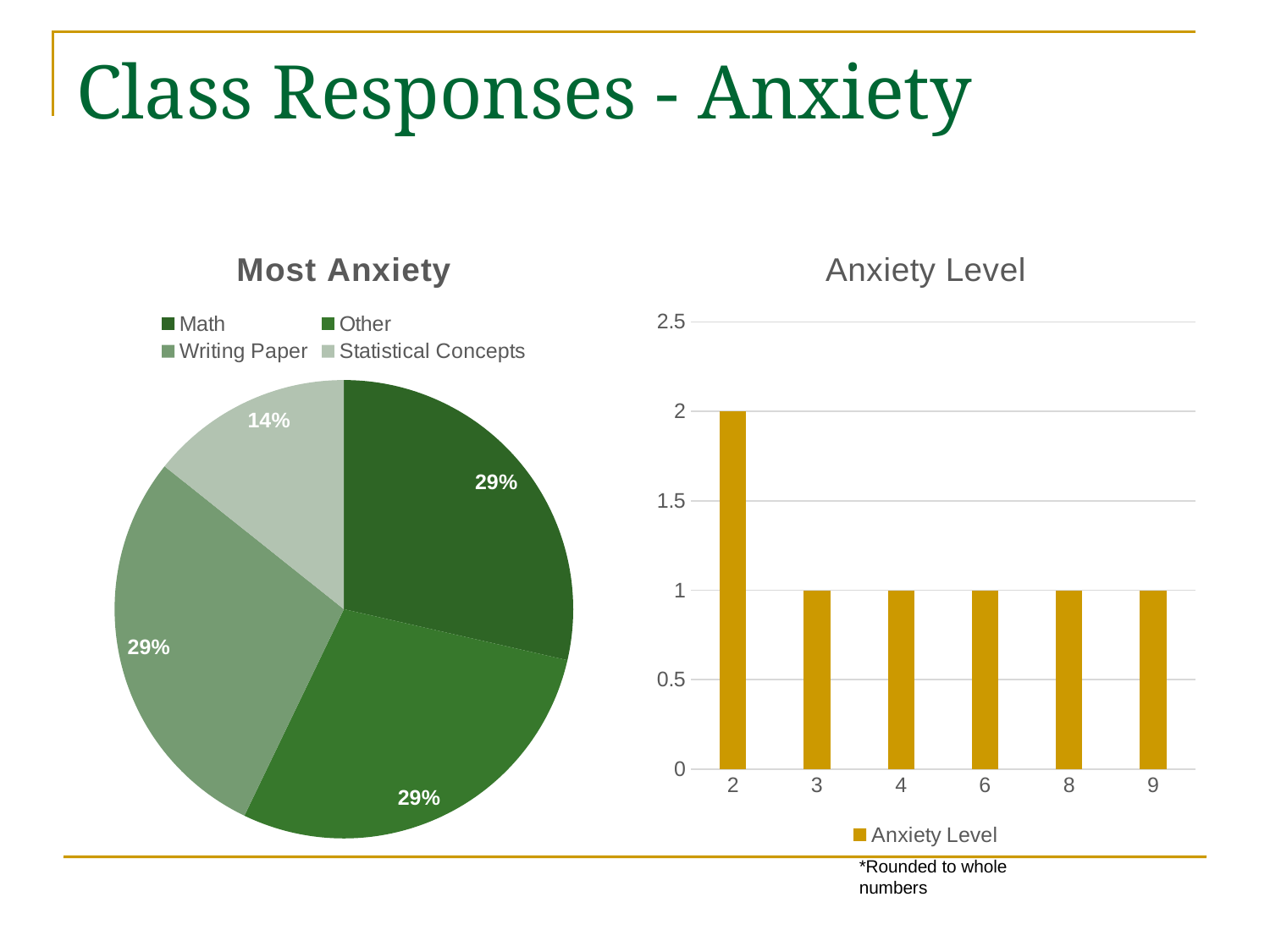
What kind of chart is the Anxiety Level chart? Bar chart In the Most Anxiety pie chart, how many categories does the legend list? 4 In the Most Anxiety pie chart, what is the difference between the Other share and the Statistical Concepts share? 15% What kind of chart is the Most Anxiety chart? Pie chart In the Anxiety Level chart, which category has the highest value? 2 In the Anxiety Level chart, what is the value for category 6? 1 In the Most Anxiety pie chart, which category has the smallest slice? Statistical Concepts In the Anxiety Level chart, how many categories are shown on the x axis? 6 In the Most Anxiety pie chart, what share does Statistical Concepts have? 14% In the Most Anxiety pie chart, what share does Math have? 29% In the Most Anxiety pie chart, which is larger, the Writing Paper slice or the Statistical Concepts slice? Writing Paper In the Anxiety Level chart, what is the value for category 2? 2